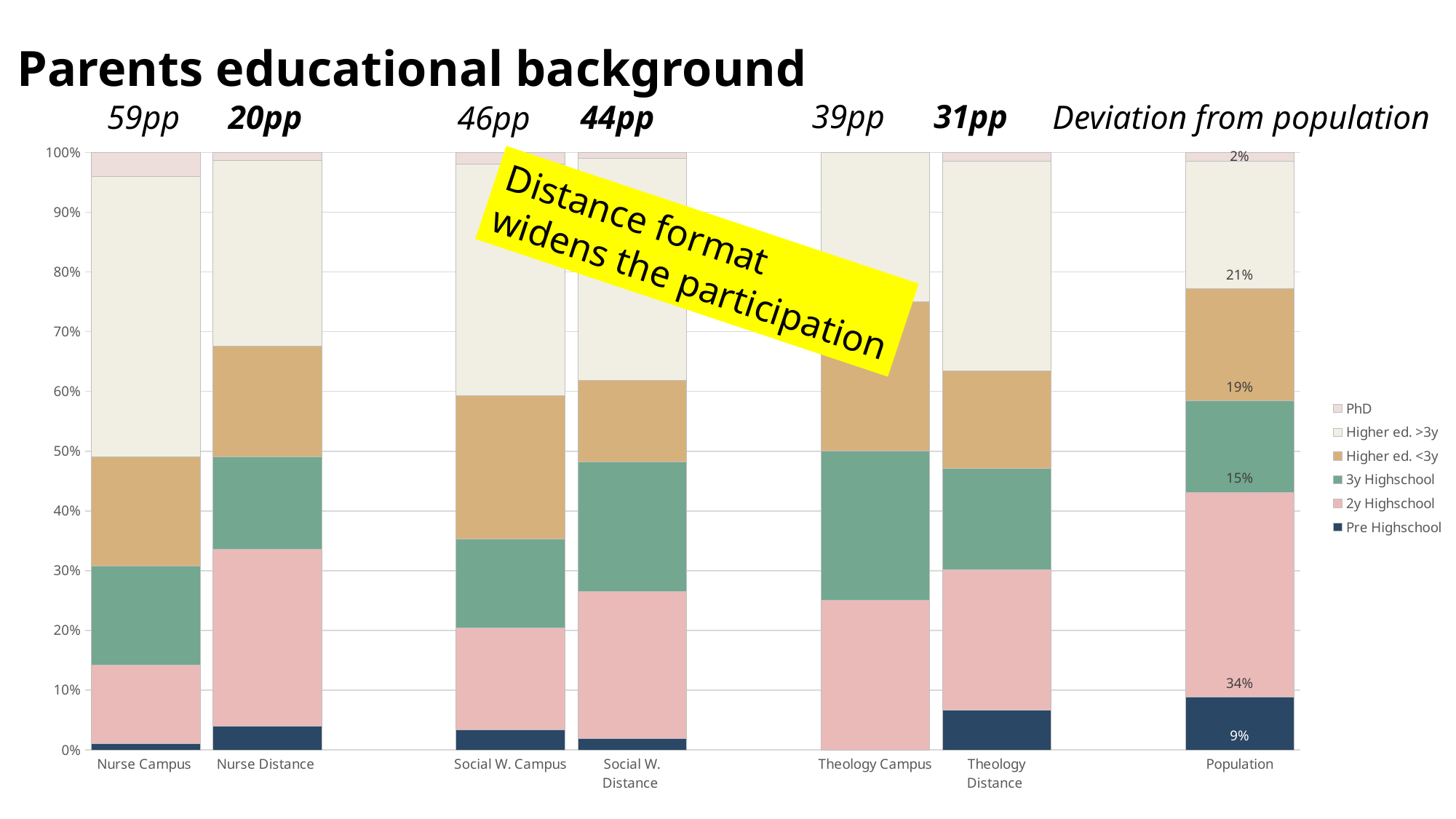
Is the combined share of Pre Highschool and 2y Highschool for Nurse Campus greater or less than 20%? less What percentage of the Population bar is 2y Highschool? 34% Which education level has the largest share in the Population bar? 2y Highschool In the Population bar, what is the difference between the 2y Highschool share and the Pre Highschool share? 25% What kind of chart is shown on the slide? Stacked bar chart What percentage of the Population bar is PhD? 2% Which education level has the smallest share in the Population bar? PhD How many bars (categories) are shown on the x axis? 7 What percentage of the Population bar is Higher ed. >3y? 21% What percentage of the Population bar is Pre Highschool? 9% How many series does the legend list? 6 Is the 2y Highschool segment larger for Nurse Campus or Nurse Distance? Nurse Distance